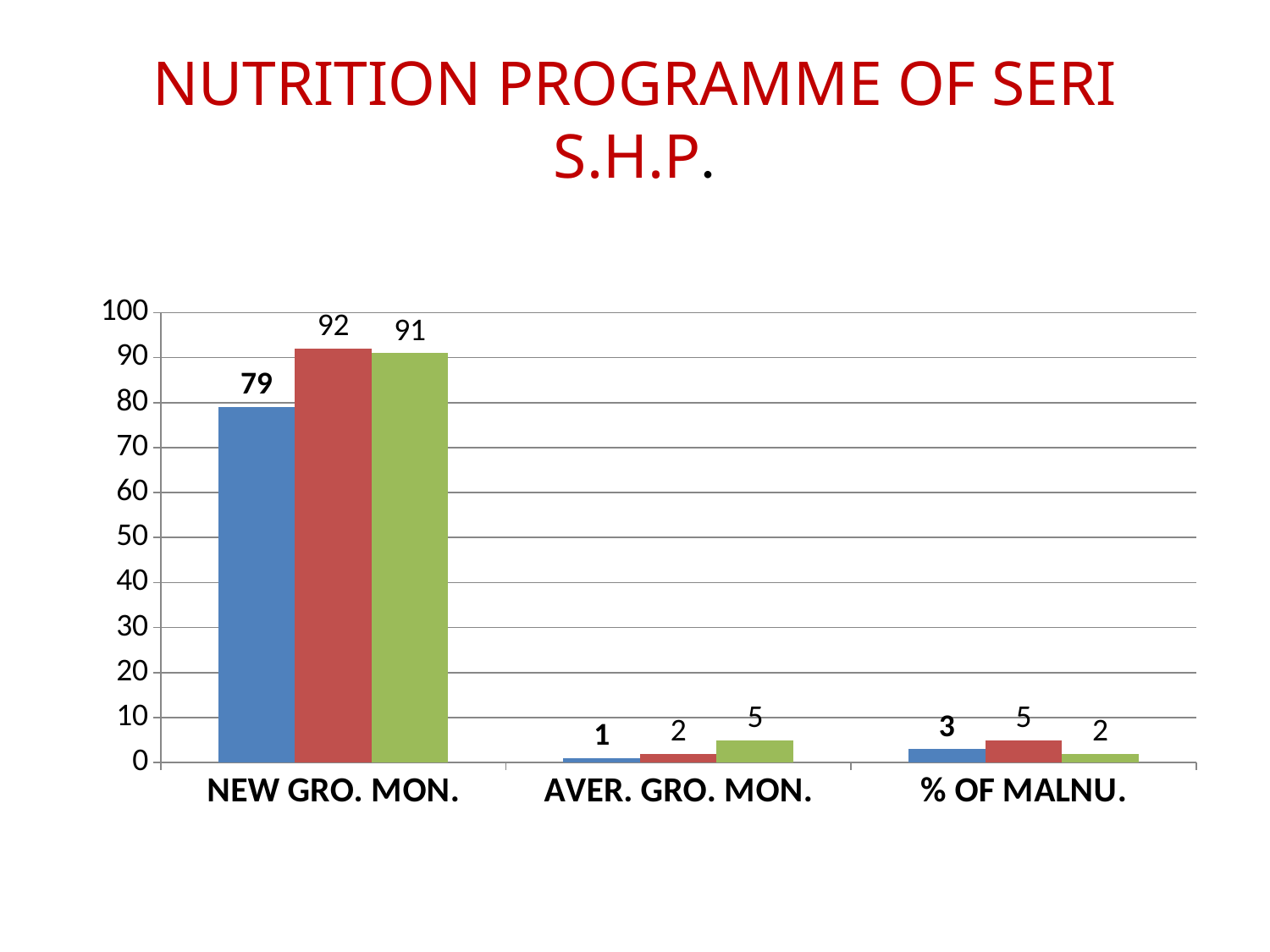
What is the value of the blue bar for NEW GRO. MON.? 79 Which category has the lowest value for the blue bars? AVER. GRO. MON. What kind of chart is shown on the slide? bar chart Is the value of the blue bar for NEW GRO. MON. greater or less than 70? greater For % OF MALNU., which is larger, the blue bar or the green bar? the blue bar What is the value of the red bar for NEW GRO. MON.? 92 What is the value of the red bar for % OF MALNU.? 5 What is the difference between the red bar and the blue bar for NEW GRO. MON.? 13 What is the value of the green bar for AVER. GRO. MON.? 5 What is the title of the slide containing the chart? NUTRITION PROGRAMME OF SERI S.H.P. How many categories are shown on the x axis? 3 Which category has the highest value for the green bars? NEW GRO. MON.